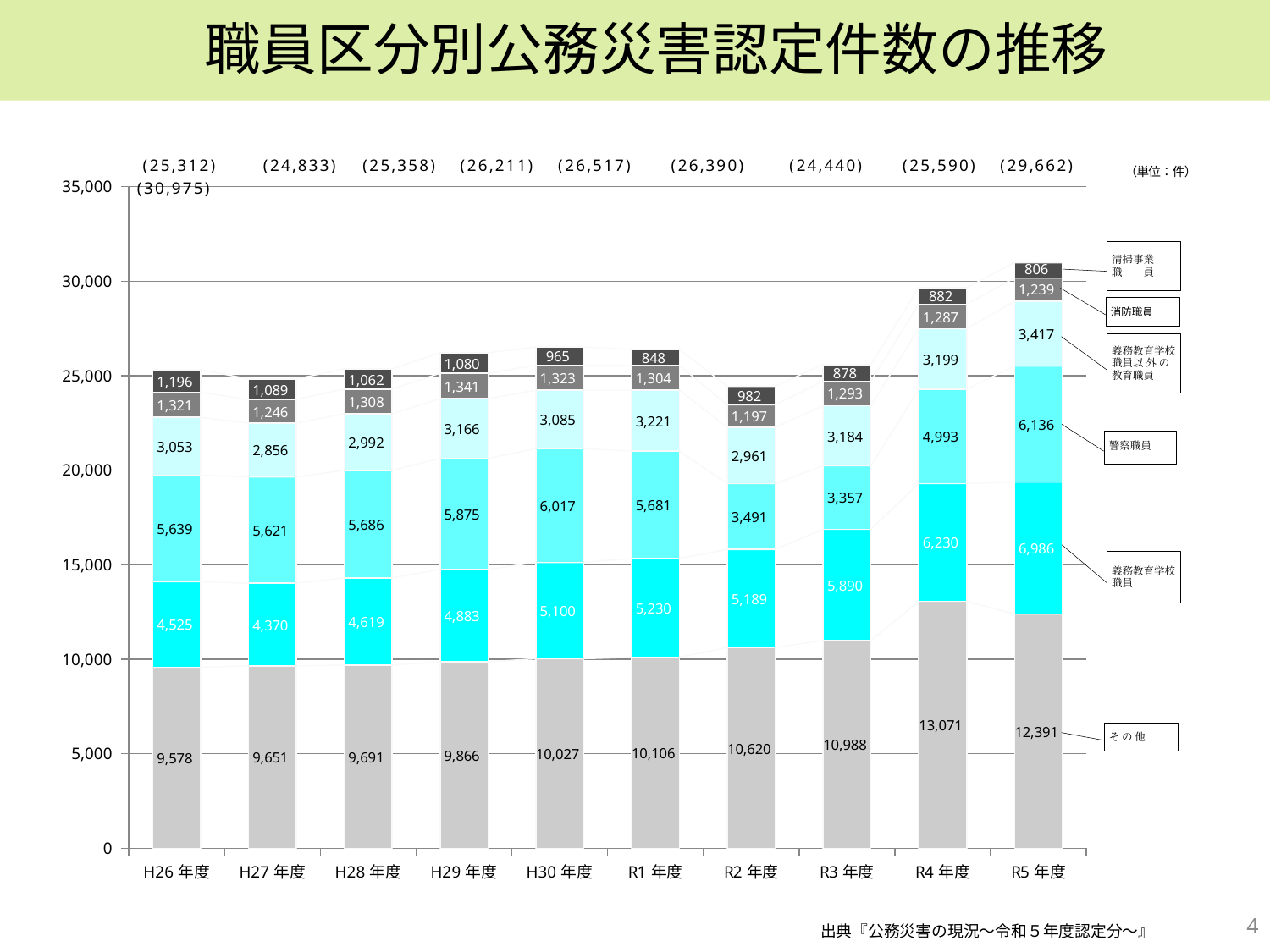
What is the value for その他 in R4 年度? 13,071 What is the value for 警察職員 in H30 年度? 6,017 Does the その他 value rise or fall from H26 年度 to R4 年度? Rises What kind of chart is shown on the slide? Stacked bar chart Which year has the lowest total number of cases? R2 年度 How many fiscal years are shown on the x axis? 10 What is the difference between the その他 values for R4 年度 and R5 年度? 680 What is the total of the stacked bar for R1 年度? 26,390 How many staff categories (series) are stacked in each bar? 6 What is the value for 消防職員 in H29 年度? 1,341 Which year has the highest total number of cases? R5 年度 Which is larger, the 義務教育学校職員 value for R4 年度 or for R5 年度? R5 年度